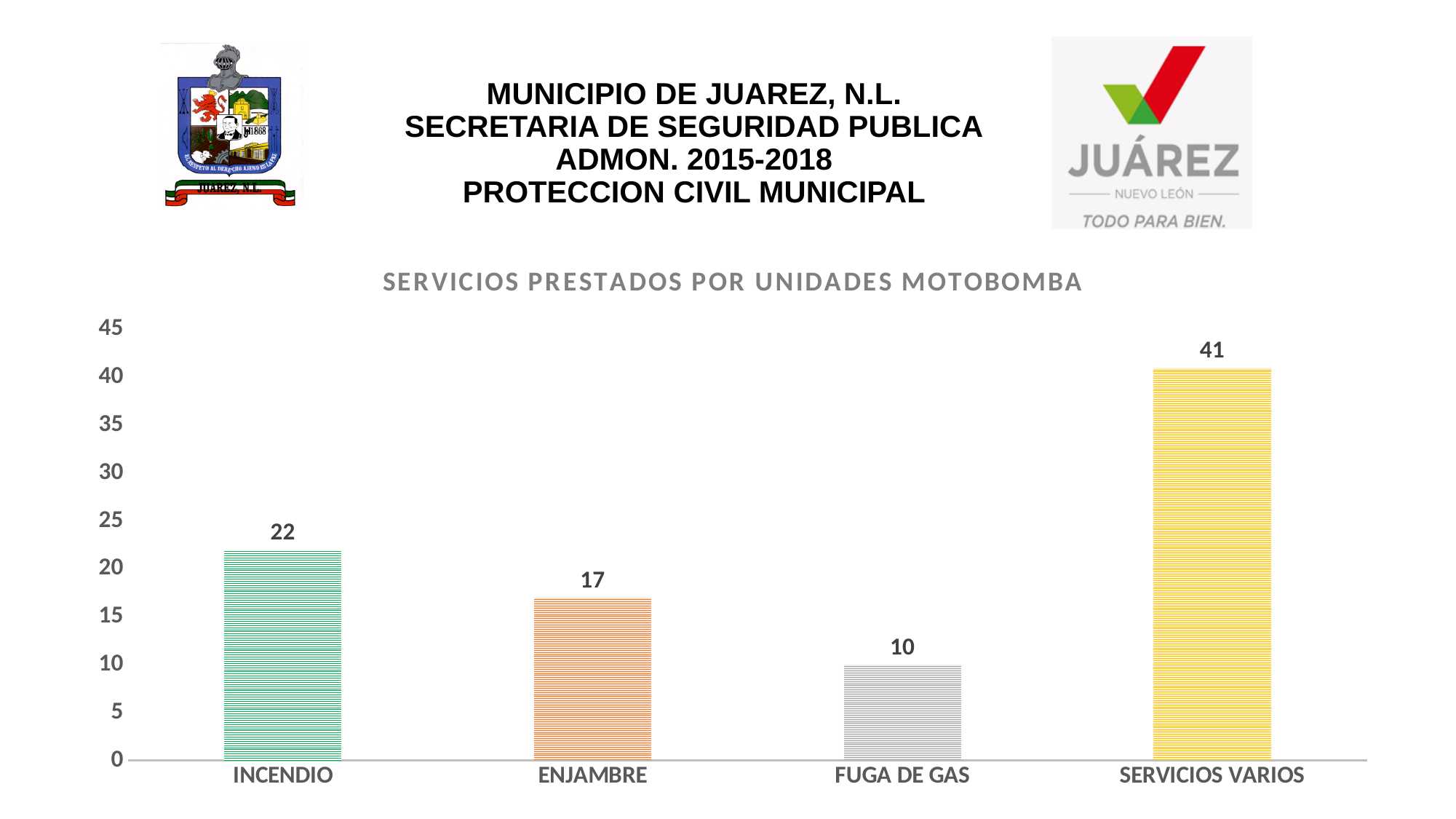
What is the value for SERVICIOS VARIOS? 41 What kind of chart is shown on the slide? bar chart Which category has the lowest value? FUGA DE GAS What is the value for ENJAMBRE? 17 What is the difference between the values for INCENDIO and ENJAMBRE? 5 Which is larger, the value for ENJAMBRE or the value for FUGA DE GAS? ENJAMBRE What is the value for FUGA DE GAS? 10 What is the title of the chart? SERVICIOS PRESTADOS POR UNIDADES MOTOBOMBA What is the difference between the values for SERVICIOS VARIOS and INCENDIO? 19 How many categories are shown in the chart? 4 What is the value for INCENDIO? 22 Which category has the highest value? SERVICIOS VARIOS